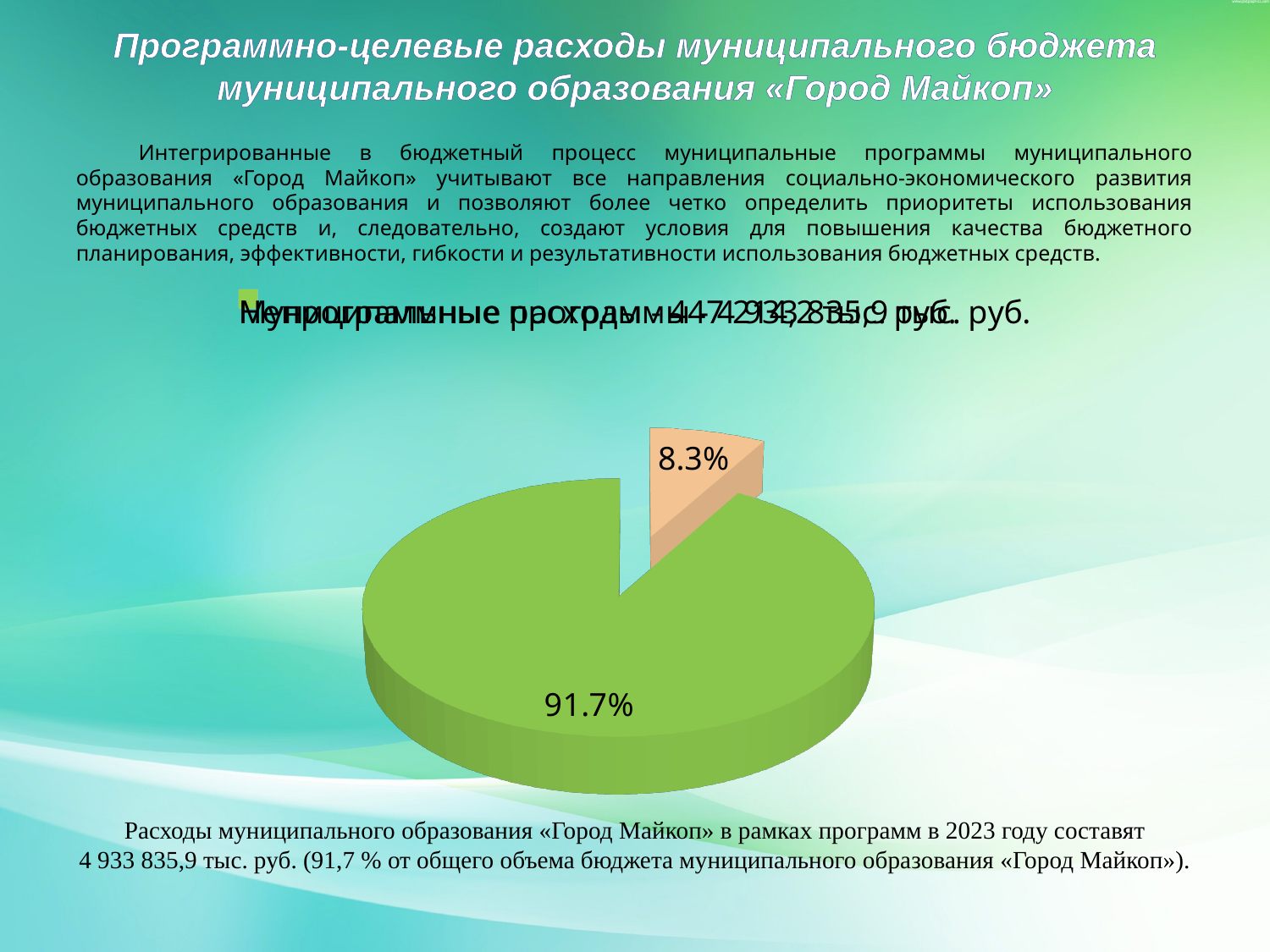
How many slices does the pie chart have? 2 What kind of chart is shown on the slide? pie chart What share of the pie does the green slice represent? 91.7% What is the percentage shown on the largest slice of the pie chart? 91.7% Is the share of the orange slice greater or less than 10%? less Which slice is larger, the green one or the orange one? the green one By how many percentage points does the green slice exceed the orange slice? 83.4 What share of the pie does the small orange slice represent? 8.3% Is the pie chart drawn in 3D? yes What colour is the largest slice of the pie chart? green What is the percentage shown on the smallest slice of the pie chart? 8.3%